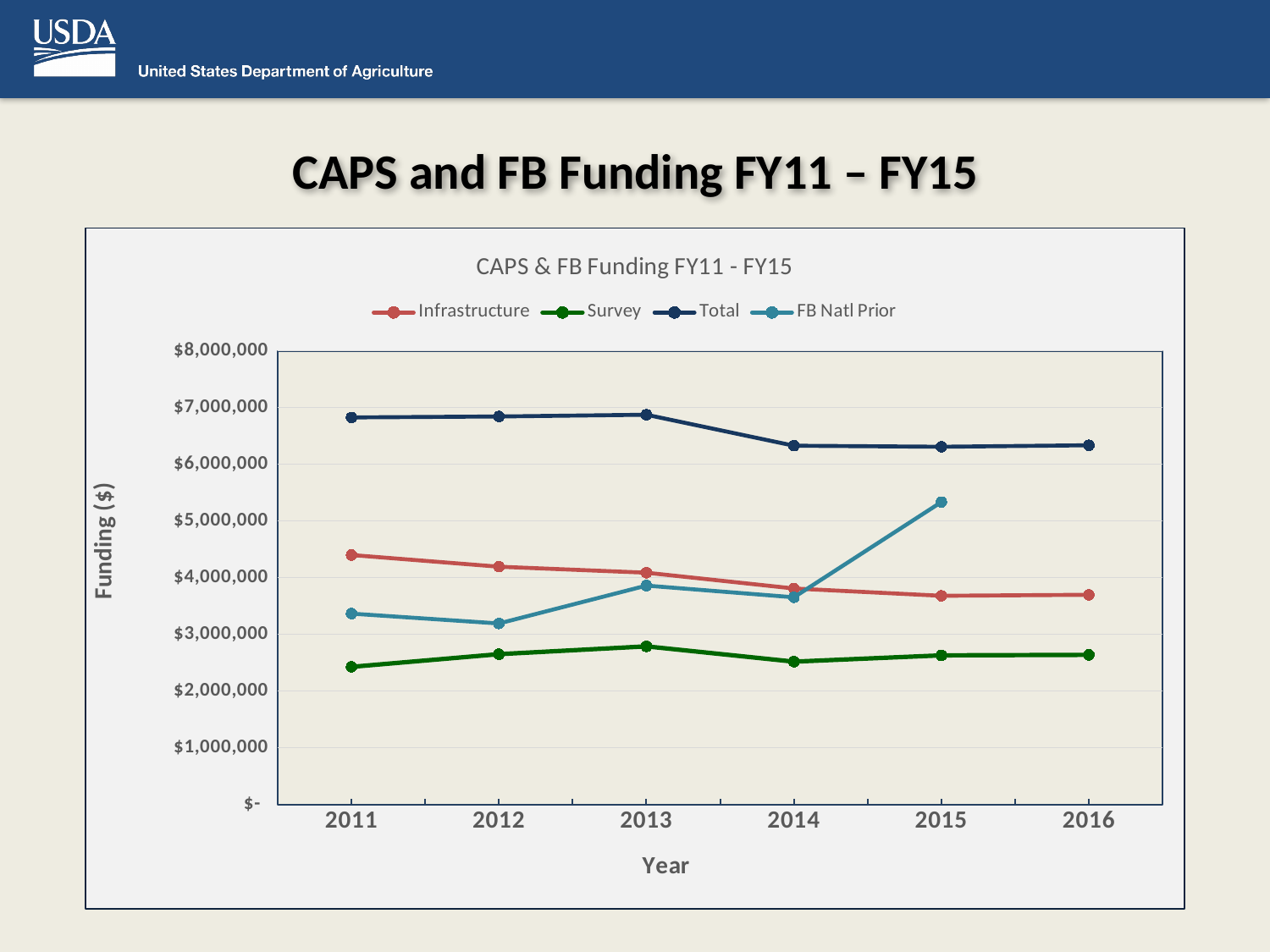
How many series does the legend list? 4 Is the value for FB Natl Prior in 2015 greater or less than $5,000,000? greater What is the label on the y axis? Funding ($) Is the value for Infrastructure in 2011 greater or less than $4,000,000? greater What kind of chart is shown on the slide? Line chart In 2015, which is larger: Infrastructure or FB Natl Prior? FB Natl Prior Is the value for Survey in 2011 greater or less than $3,000,000? less How many years are shown along the x axis? 6 Which series has the lowest value in 2014? Survey Does the Infrastructure line rise or fall from 2011 to 2015? Fall Which series has the highest value in 2013? Total